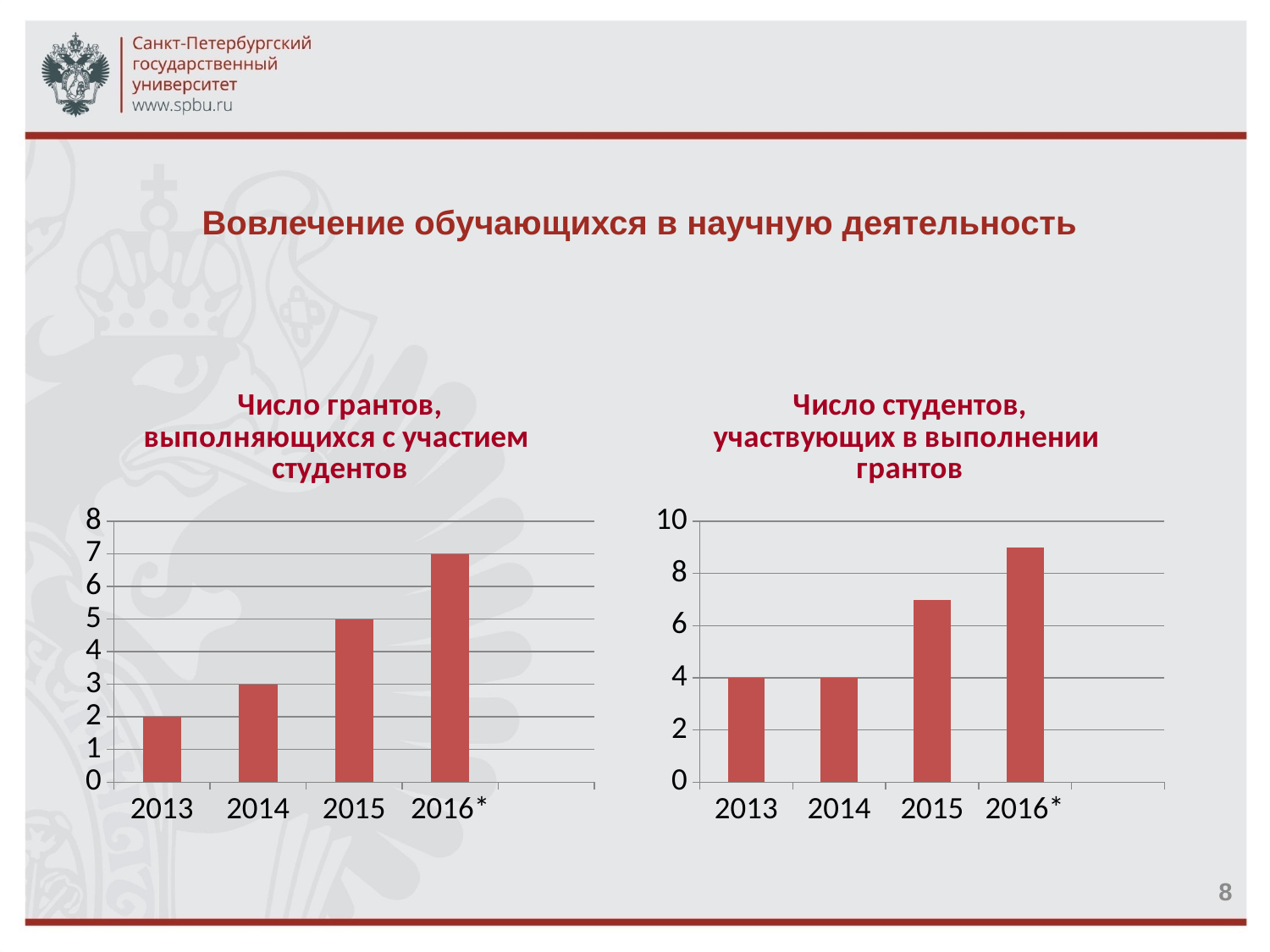
In the chart 'Число студентов, участвующих в выполнении грантов', is the value for 2016* greater or less than 8? greater In the chart 'Число грантов, выполняющихся с участием студентов', which year has the lowest value? 2013 How many categories are shown on the x axis of the chart 'Число грантов, выполняющихся с участием студентов'? 4 In the chart 'Число грантов, выполняющихся с участием студентов', what is the value for 2015? 5 In the chart 'Число студентов, участвующих в выполнении грантов', which is larger, the value for 2015 or the value for 2014? 2015 In the chart 'Число грантов, выполняющихся с участием студентов', what is the difference between the values for 2016* and 2013? 5 In the chart 'Число грантов, выполняющихся с участием студентов', do the values rise or fall from 2013 to 2016*? rise In the chart 'Число студентов, участвующих в выполнении грантов', what is the value for 2013? 4 In the chart 'Число студентов, участвующих в выполнении грантов', is the value for 2015 greater or less than 6? greater In the chart 'Число студентов, участвующих в выполнении грантов', which year has the highest value? 2016* What kind of chart is the chart on the right of the slide? bar chart In the chart 'Число грантов, выполняющихся с участием студентов', what is the value for 2016*? 7